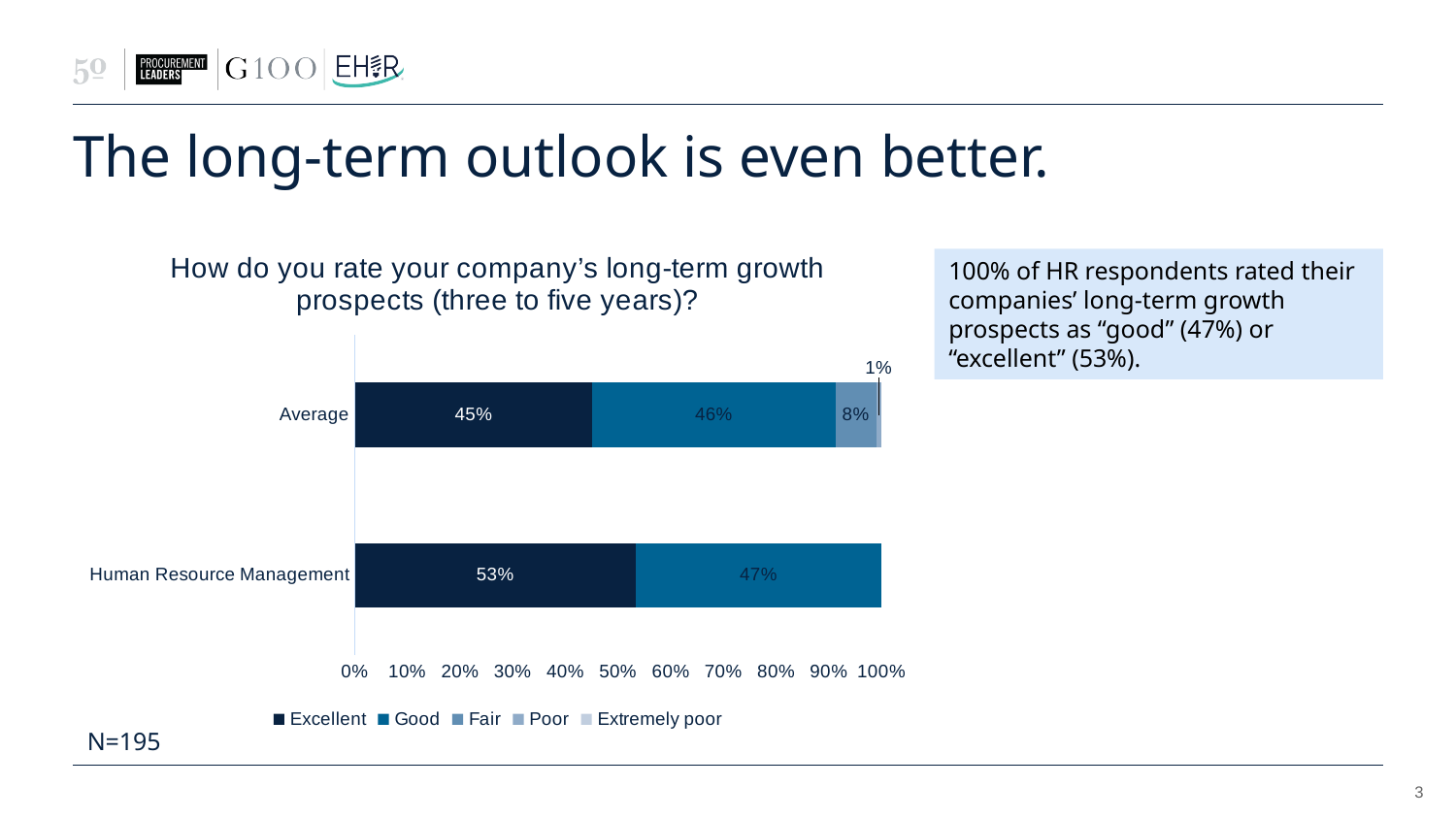
What is the Fair value for the Average category? 8% What is the Good value for the Average category? 46% How many categories are shown on the vertical axis of the chart? 2 What kind of chart is shown on the slide? Stacked bar chart What is the title of the chart? How do you rate your company's long-term growth prospects (three to five years)? What is the combined Excellent and Good share for Human Resource Management? 100% What percentage of Human Resource Management respondents rated long-term growth prospects as Excellent? 53% What is the difference between the Excellent values for Human Resource Management and Average? 8% How many series does the legend list? 5 What is the Excellent value for the Average category? 45% Which category has the higher Excellent value, Average or Human Resource Management? Human Resource Management What percentage of Human Resource Management respondents rated long-term growth prospects as Good? 47%